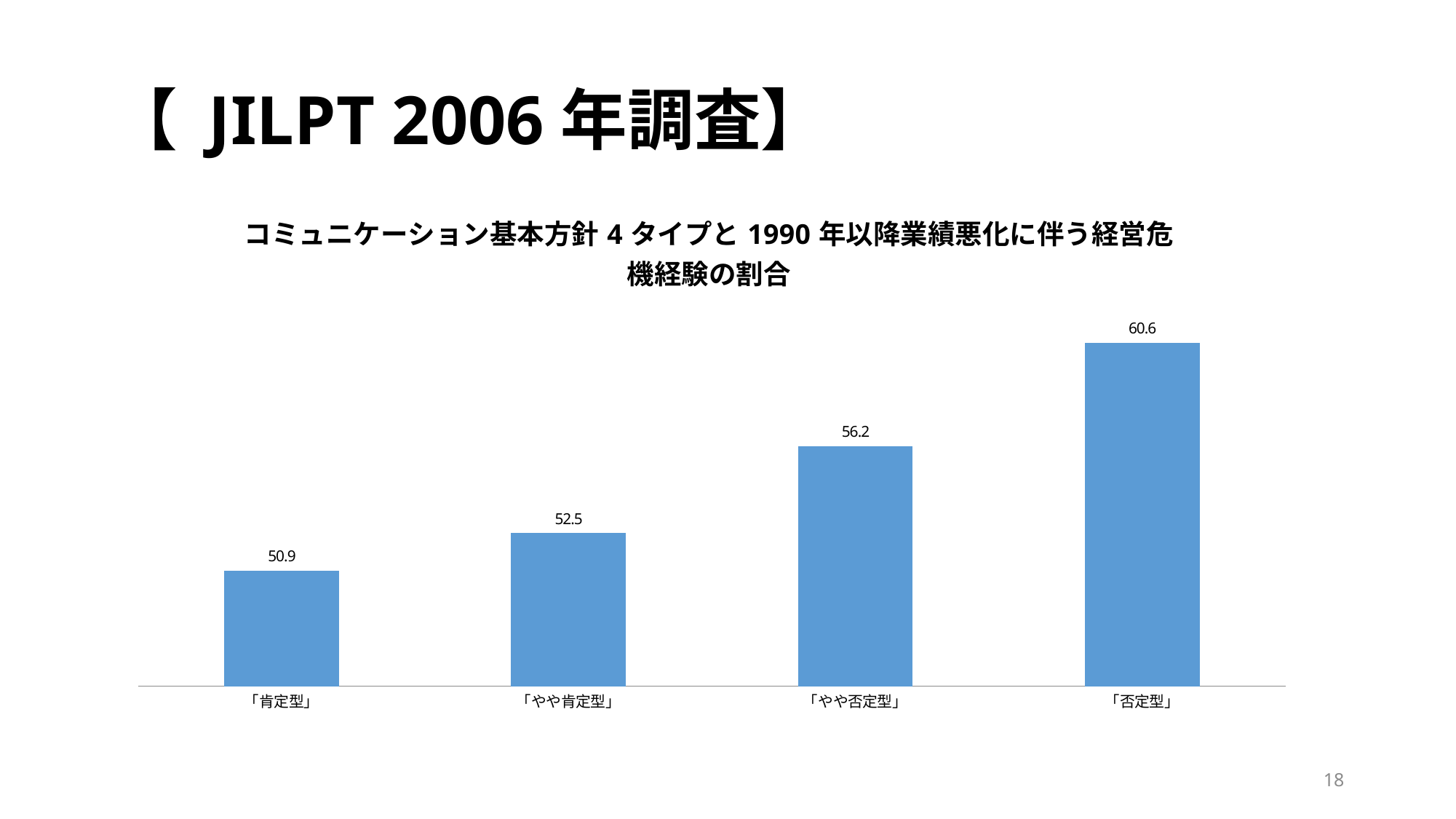
What is the value for 「否定型」? 60.6 What is the difference between the values for 「否定型」 and 「肯定型」? 9.7 Which is larger, the value for 「やや肯定型」 or the value for 「やや否定型」? 「やや否定型」 Which category has the lowest value? 「肯定型」 Do the values rise or fall from left to right along the x axis? Rise What kind of chart is shown on the slide? Bar chart What is the value for 「やや否定型」? 56.2 What is the value for 「肯定型」? 50.9 How many categories are shown in the chart? 4 Which category has the highest value? 「否定型」 What is the value for 「やや肯定型」? 52.5 What is the difference between the values for 「やや否定型」 and 「やや肯定型」? 3.7